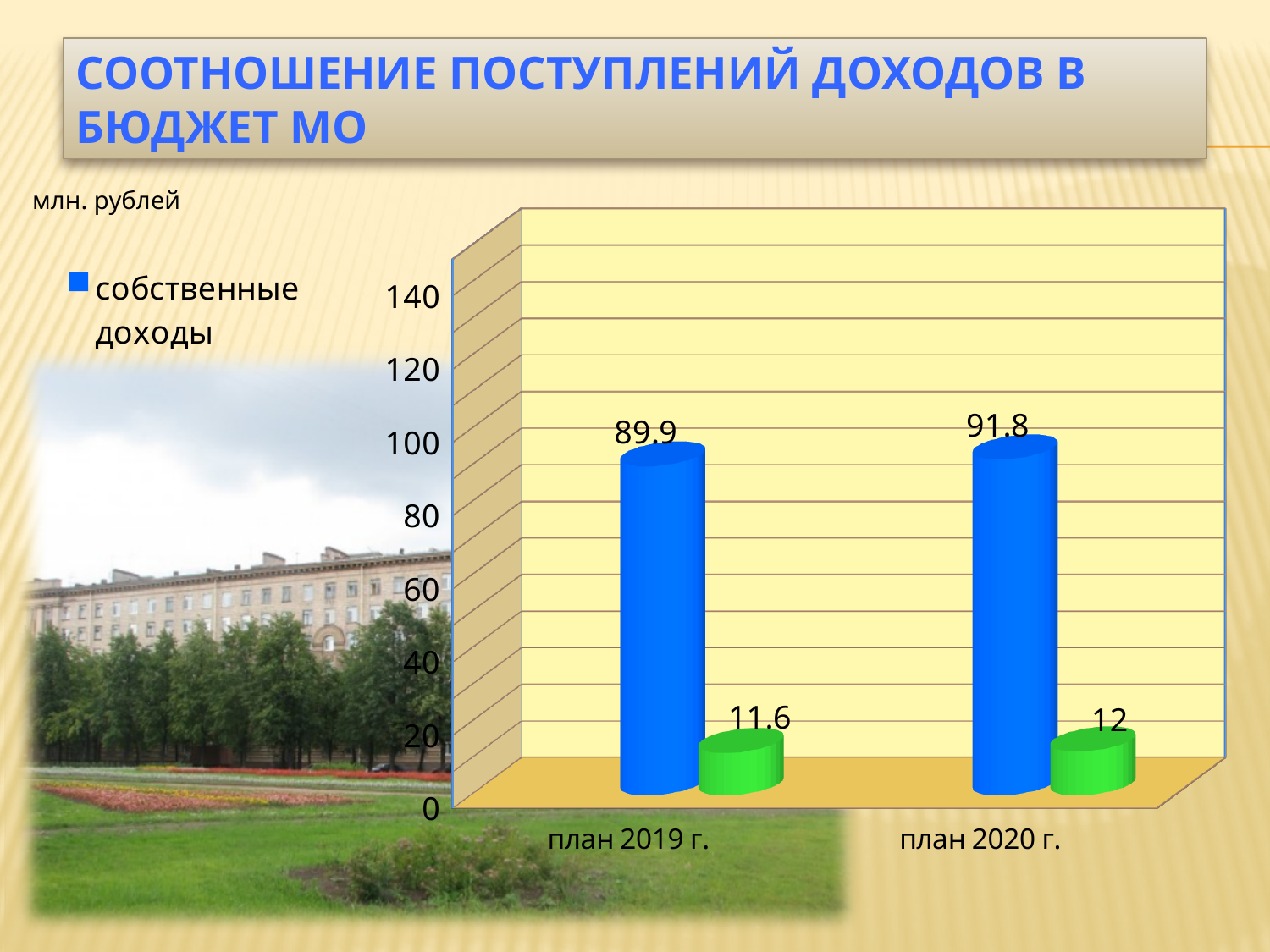
What is the value of the green bar for план 2019 г.? 11.6 Which category has the higher value for собственные доходы, план 2019 г. or план 2020 г.? план 2020 г. What is the value of собственные доходы for план 2019 г.? 89.9 What unit is indicated for the chart values? млн. рублей What type of chart is shown on the slide? bar chart What is the difference between the green bar values for план 2020 г. and план 2019 г.? 0.4 How many categories are shown on the x axis? 2 What is the value of the green bar for план 2020 г.? 12 What is the difference between собственные доходы for план 2020 г. and план 2019 г.? 1.9 Do the values for собственные доходы rise or fall from план 2019 г. to план 2020 г.? rise Is the value of собственные доходы for план 2019 г. greater or less than 100? less What is the value of собственные доходы for план 2020 г.? 91.8